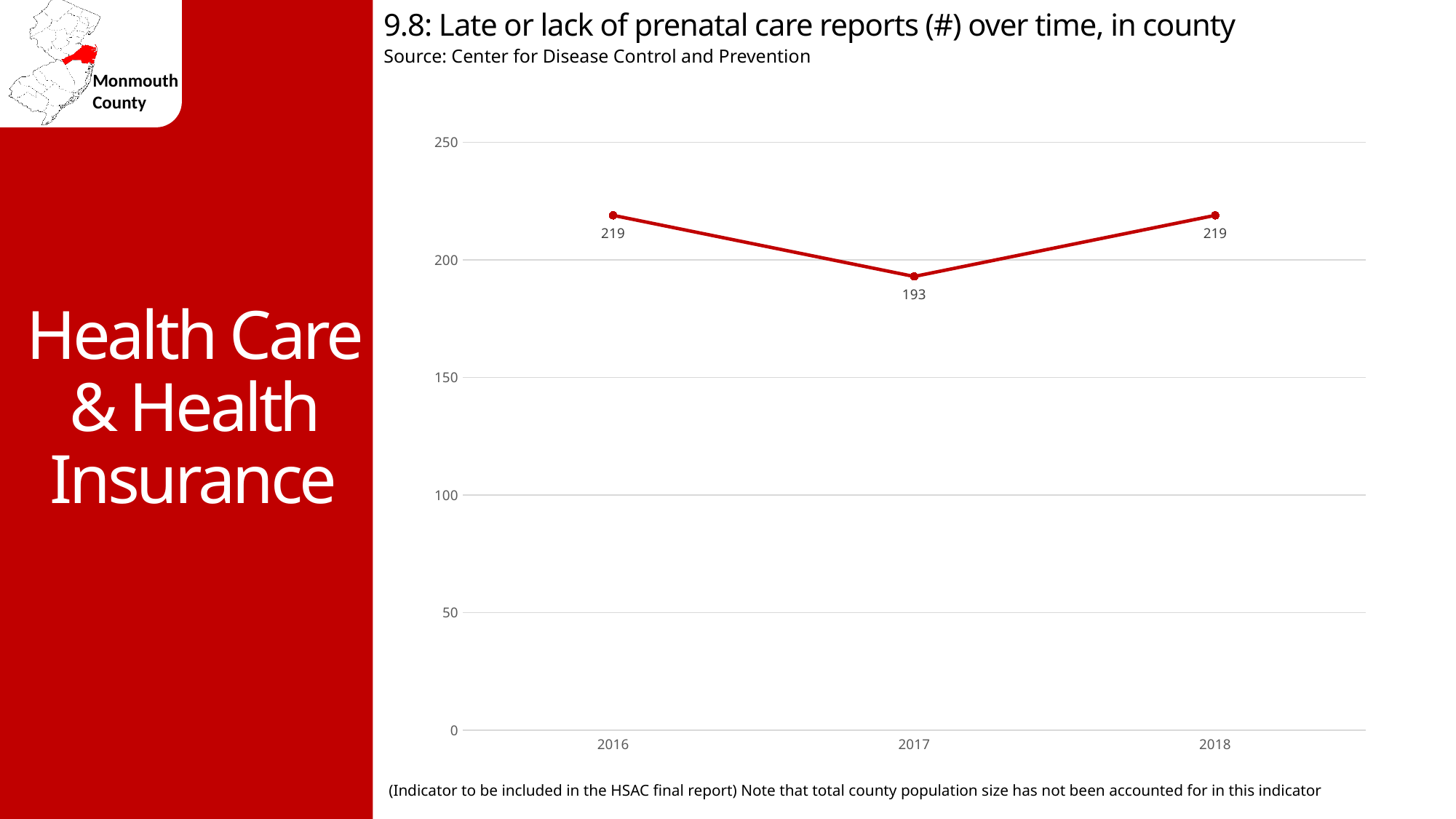
Which is larger, the value for 2017 or the value for 2018? 2018 Does the value rise or fall from 2017 to 2018? rise Is the value for 2016 greater or less than 200? greater What is the difference between the 2016 value and the 2017 value? 26 What kind of chart is shown on the slide? line chart What is the source cited for the chart? Center for Disease Control and Prevention What is the number of late or lack of prenatal care reports in 2016? 219 How many years are plotted on the chart? 3 Is the value for 2017 greater or less than 200? less What is the number of late or lack of prenatal care reports in 2018? 219 What is the number of late or lack of prenatal care reports in 2017? 193 Which year has the lowest number of late or lack of prenatal care reports? 2017